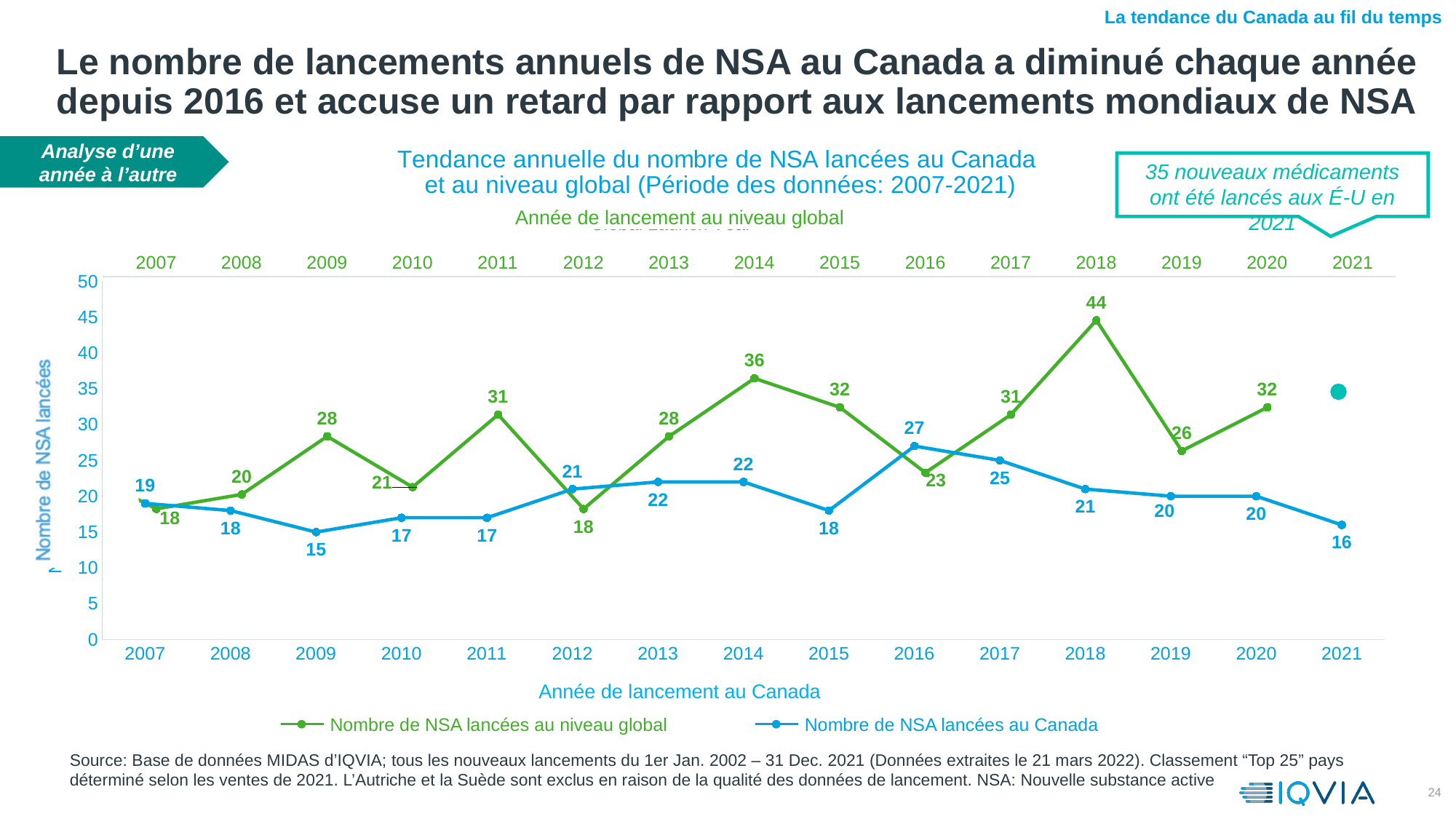
How many series does the legend list? 2 What is the difference between the global and Canadian NSA launches in 2018? 23 What is the number of NSA launched globally in 2014? 36 What is the number of NSA launched in Canada in 2016? 27 In which year was the number of NSA launched globally the highest? 2018 Did the number of NSA launched in Canada rise or fall from 2016 to 2021? fall In which year was the number of NSA launched in Canada the lowest? 2009 What is the number of NSA launched in Canada in 2021? 16 In 2016, which was larger: the number of NSA launched globally or in Canada? Canada How many years are shown on the x axis of the chart? 15 Which colour represents the series 'Nombre de NSA lancées au Canada'? blue What kind of chart is shown on the slide? line chart